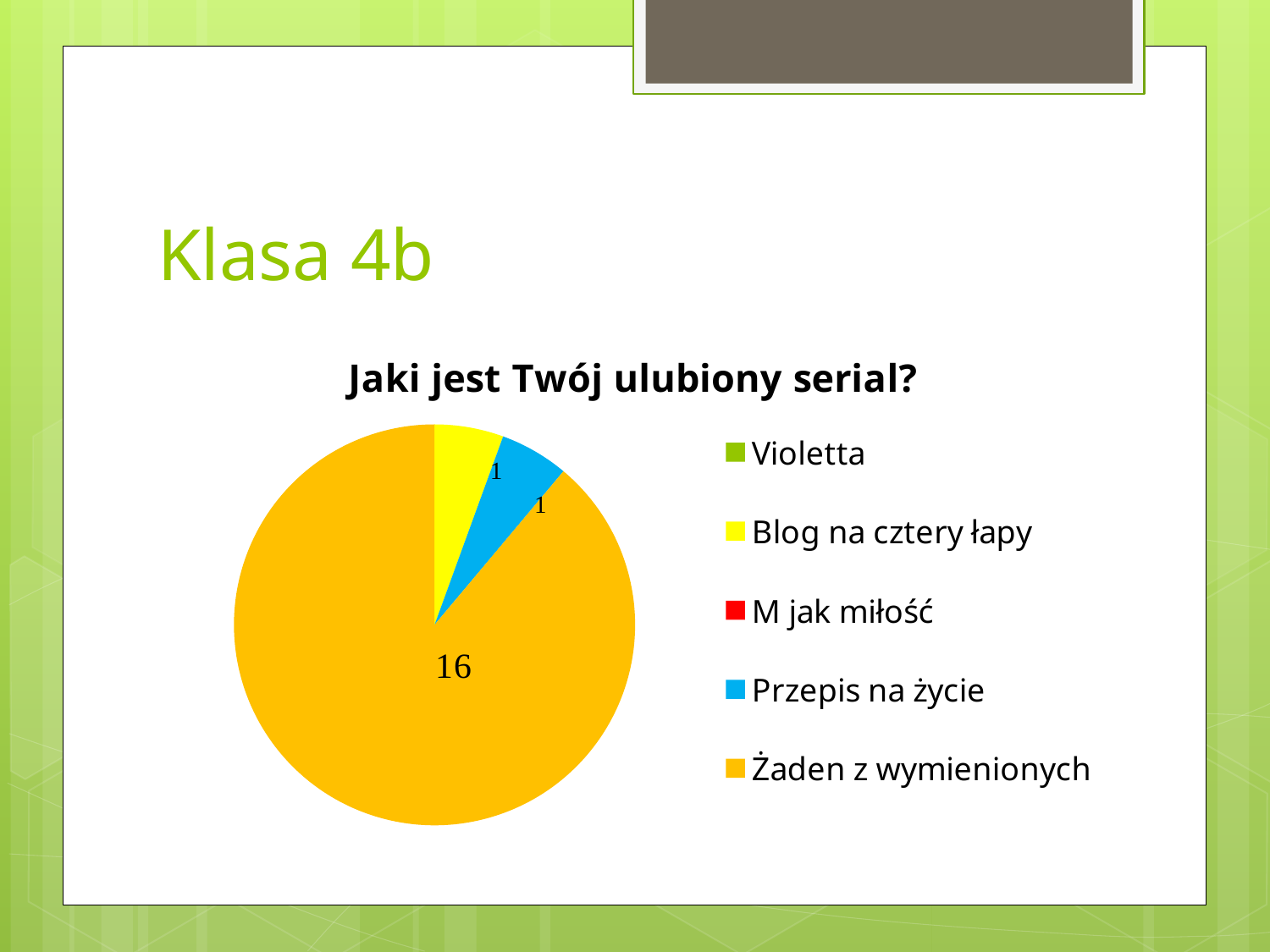
What value is shown for the "Blog na cztery łapy" slice in the pie chart? 1 What colour is the "Żaden z wymienionych" slice in the pie chart? Orange Which is larger: the value for "Żaden z wymienionych" or the value for "Blog na cztery łapy"? Żaden z wymienionych What value is shown for the "Przepis na życie" slice in the pie chart? 1 Which category has the largest slice in the pie chart? Żaden z wymienionych What value is shown for the "Żaden z wymienionych" slice in the pie chart? 16 How many entries does the chart's legend list? 5 What is the title of the chart? Jaki jest Twój ulubiony serial? What is the difference between the value for "Żaden z wymienionych" and the value for "Przepis na życie"? 15 What kind of chart is shown on the slide? Pie chart